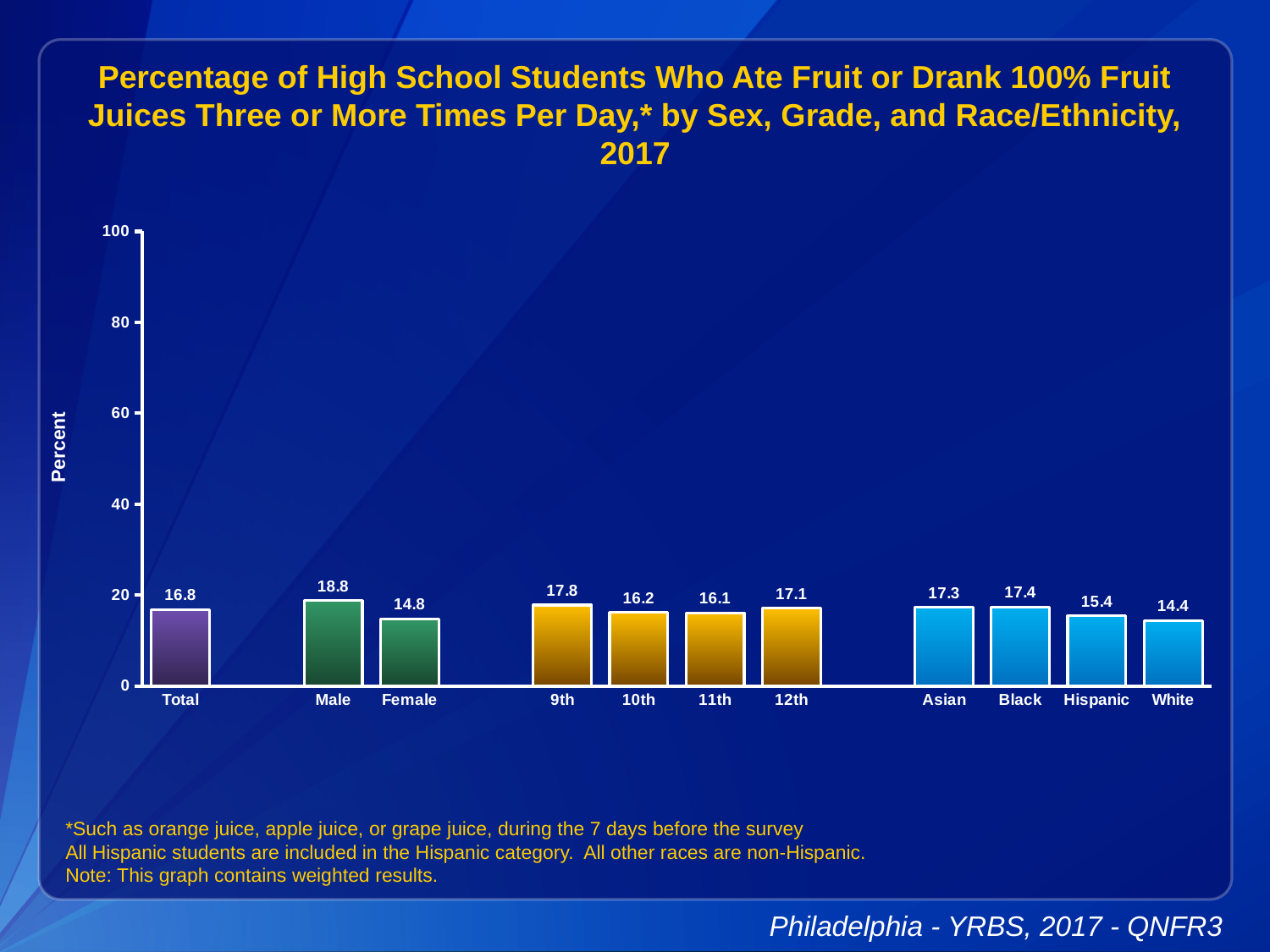
What is the value for Hispanic? 15.4 Is the value for Female greater or less than 20? less How many categories are shown on the x axis? 11 What is the label of the y axis? Percent Which category has the highest value? Male What kind of chart is this? bar chart What is the difference between the values for Black and White? 3.0 What is the value for Total? 16.8 Which category has the lowest value? White Which is larger, the value for 9th or the value for 12th? 9th What is the value for Male? 18.8 What is the difference between the values for Male and Female? 4.0